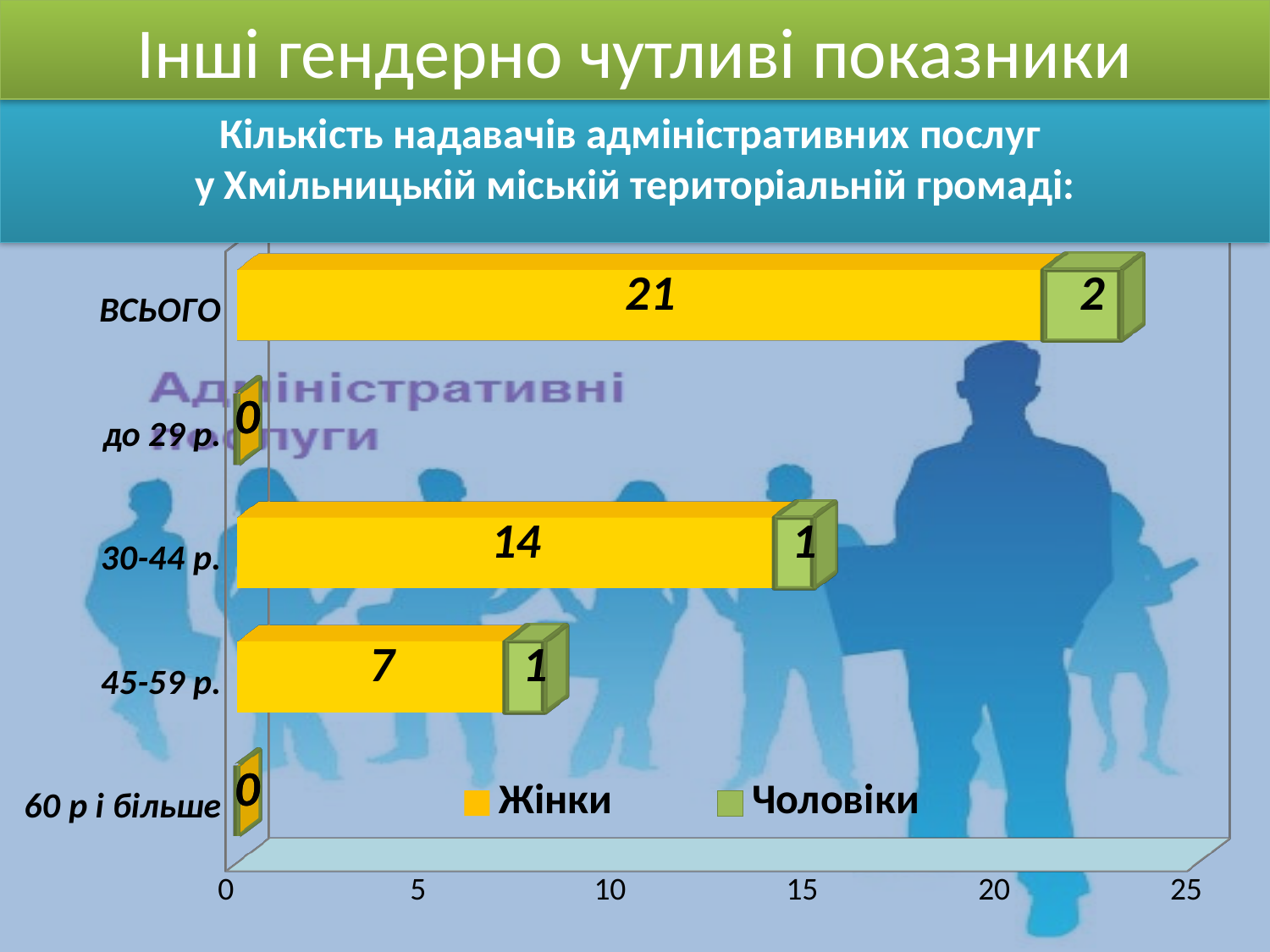
How many series does the legend list? 2 What is the total of the stacked bar for 30-44 р.? 15 What is the difference between the Жінки values for 30-44 р. and 45-59 р.? 7 What is the value for Жінки in the 30-44 р. category? 14 What is the value for Жінки in the ВСЬОГО category? 21 What is the value for Жінки in the 45-59 р. category? 7 Among the age groups (not counting ВСЬОГО), which has the highest Жінки value? 30-44 р. What is the total of the stacked bar for ВСЬОГО? 23 How many categories are shown on the vertical axis of the chart? 5 What is the value for Чоловіки in the 45-59 р. category? 1 Which has the larger Жінки value: 30-44 р. or 45-59 р.? 30-44 р. What is the value for Чоловіки in the ВСЬОГО category? 2